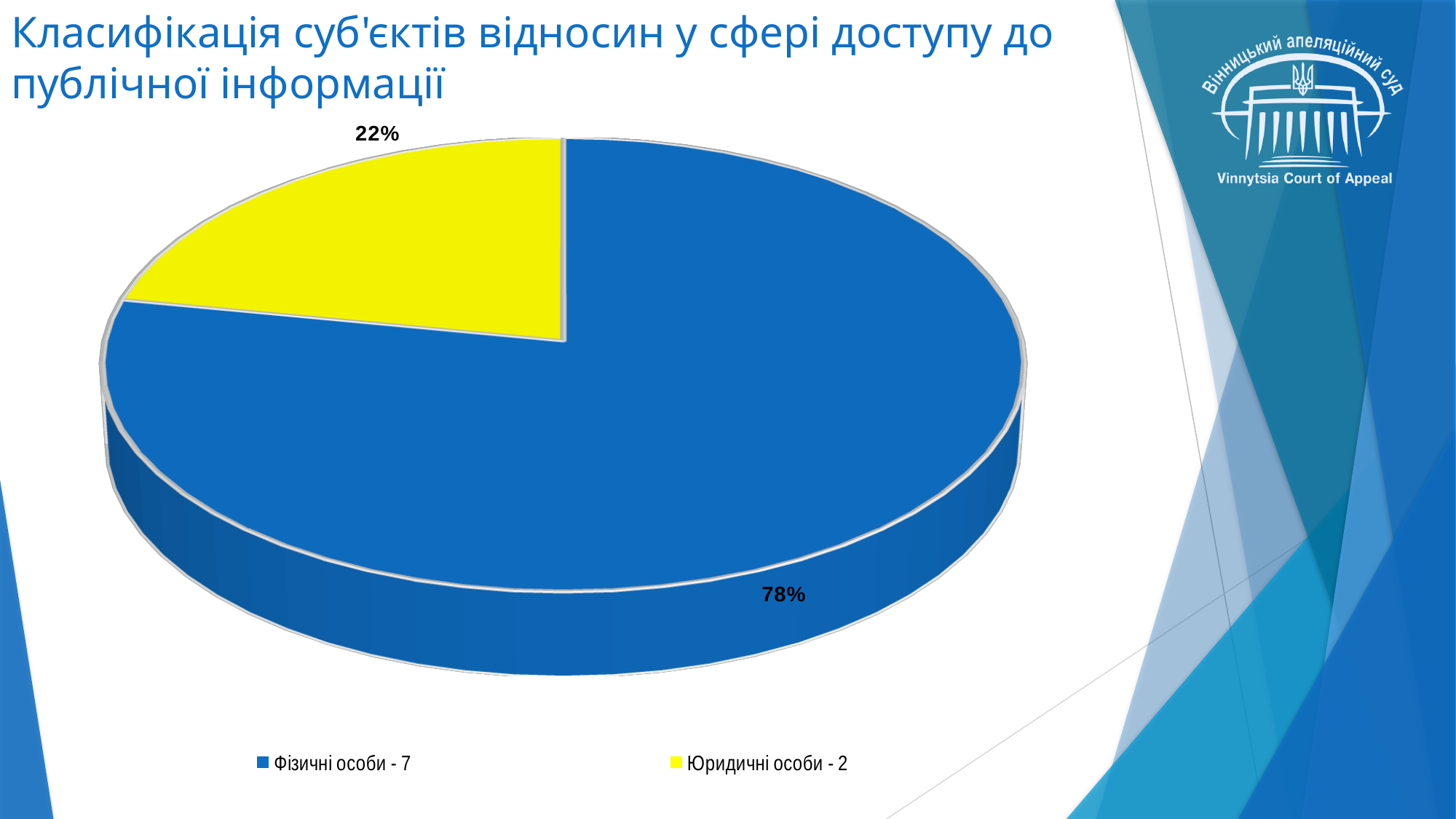
How many slices does the pie chart have? 2 How many entries does the legend list? 2 Which category has the smallest slice of the pie? Юридичні особи What colour is the slice for Юридичні особи? yellow What kind of chart is shown on the slide? pie chart What count is shown in the legend for Юридичні особи? 2 What is the difference in percentage points between the Фізичні особи slice and the Юридичні особи slice? 56 What percentage share does the slice for Фізичні особи have? 78% What percentage share does the slice for Юридичні особи have? 22% What count is shown in the legend for Фізичні особи? 7 Which category has the largest slice of the pie? Фізичні особи Which slice is larger: Фізичні особи or Юридичні особи? Фізичні особи